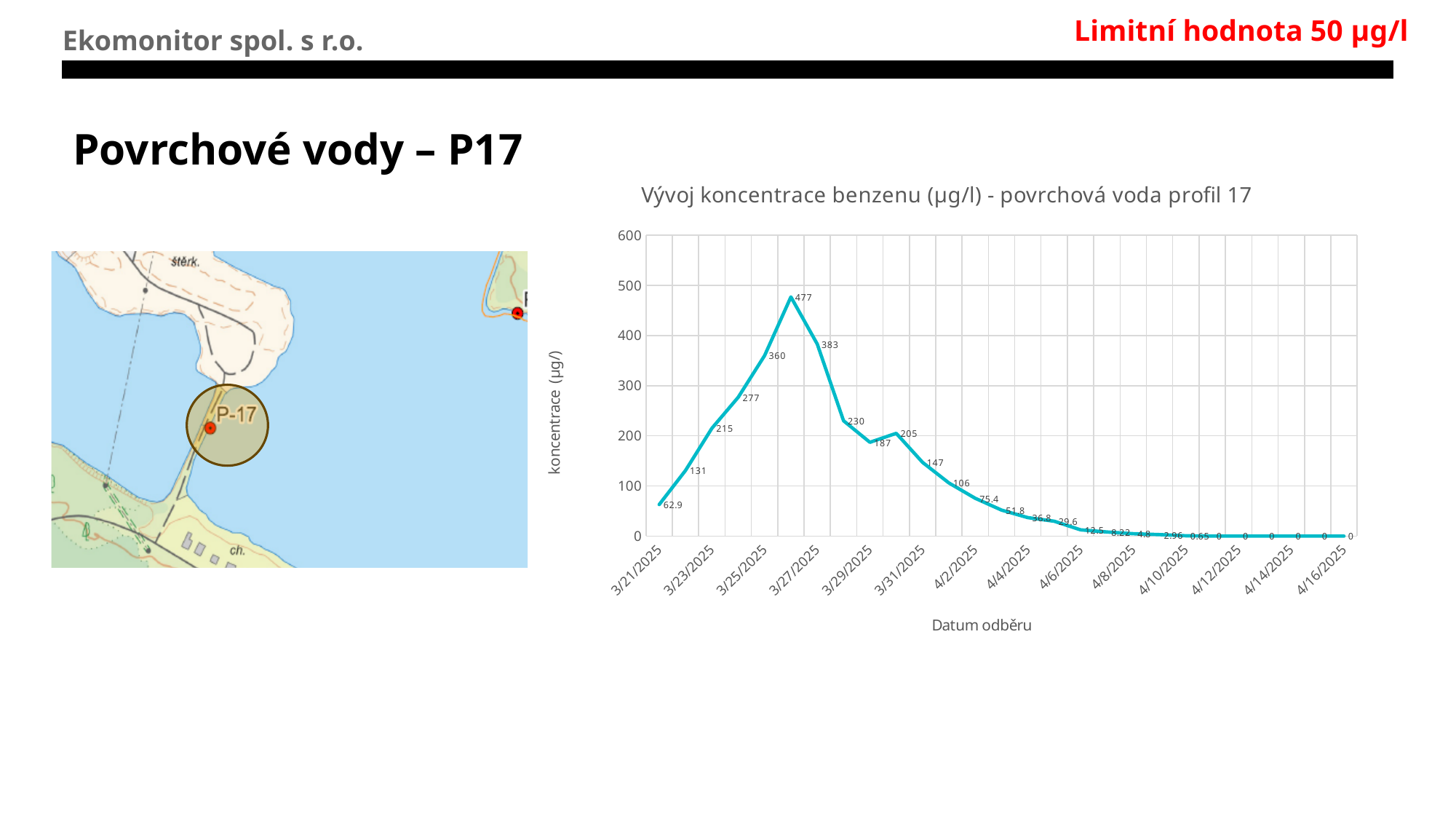
What is the benzene concentration on 3/23/2025? 215 Do the values rise or fall along the x axis after the peak on the chart? fall Which date has the higher benzene concentration, 3/27/2025 or 3/29/2025? 3/27/2025 What is the highest benzene concentration value plotted on the chart? 477 What is the benzene concentration on 4/16/2025? 0 What is the benzene concentration on 3/25/2025? 360 What is the title of the y axis on the chart? koncentrace (µg/l) What is the benzene concentration on 3/31/2025? 147 What is the benzene concentration on 3/21/2025? 62.9 By how much does the benzene concentration on 3/25/2025 exceed that on 3/23/2025? 145 What kind of chart is shown on the slide? line chart What is the benzene concentration on 3/27/2025? 383